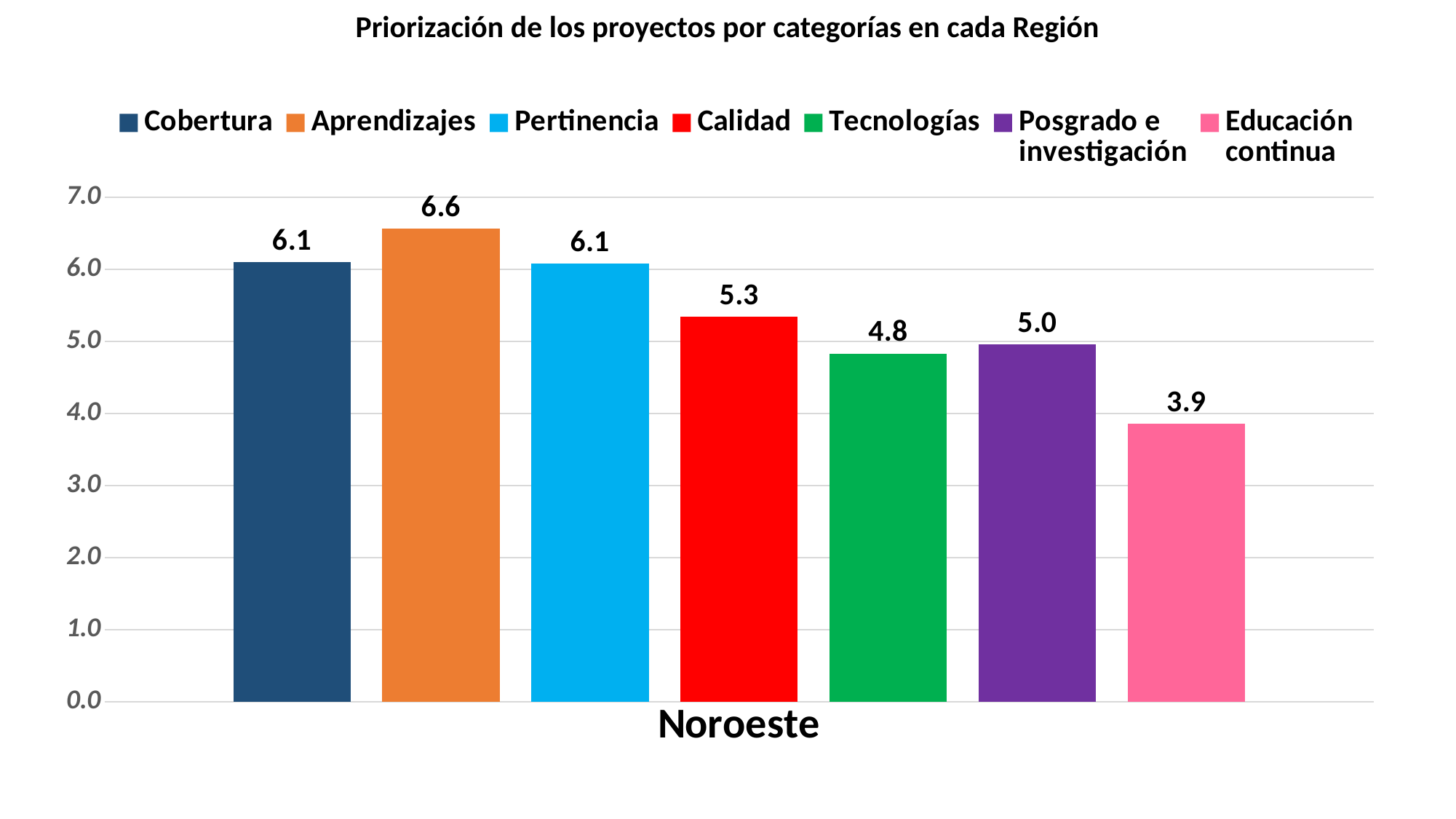
How many series does the legend list? 7 What is the difference between the values for Aprendizajes and Educación continua? 2.7 Which series has the highest value in the Noroeste region? Aprendizajes What is the value for Tecnologías in the Noroeste region? 4.8 Which series has the lowest value in the Noroeste region? Educación continua What is the difference between the values for Calidad and Tecnologías? 0.5 What kind of chart is shown on the slide? Bar chart What is the value for Educación continua in the Noroeste region? 3.9 Which is larger, the value for Calidad or the value for Posgrado e investigación? Calidad What is the value for Aprendizajes in the Noroeste region? 6.6 What is the value for Calidad in the Noroeste region? 5.3 What is the title of the chart? Priorización de los proyectos por categorías en cada Región